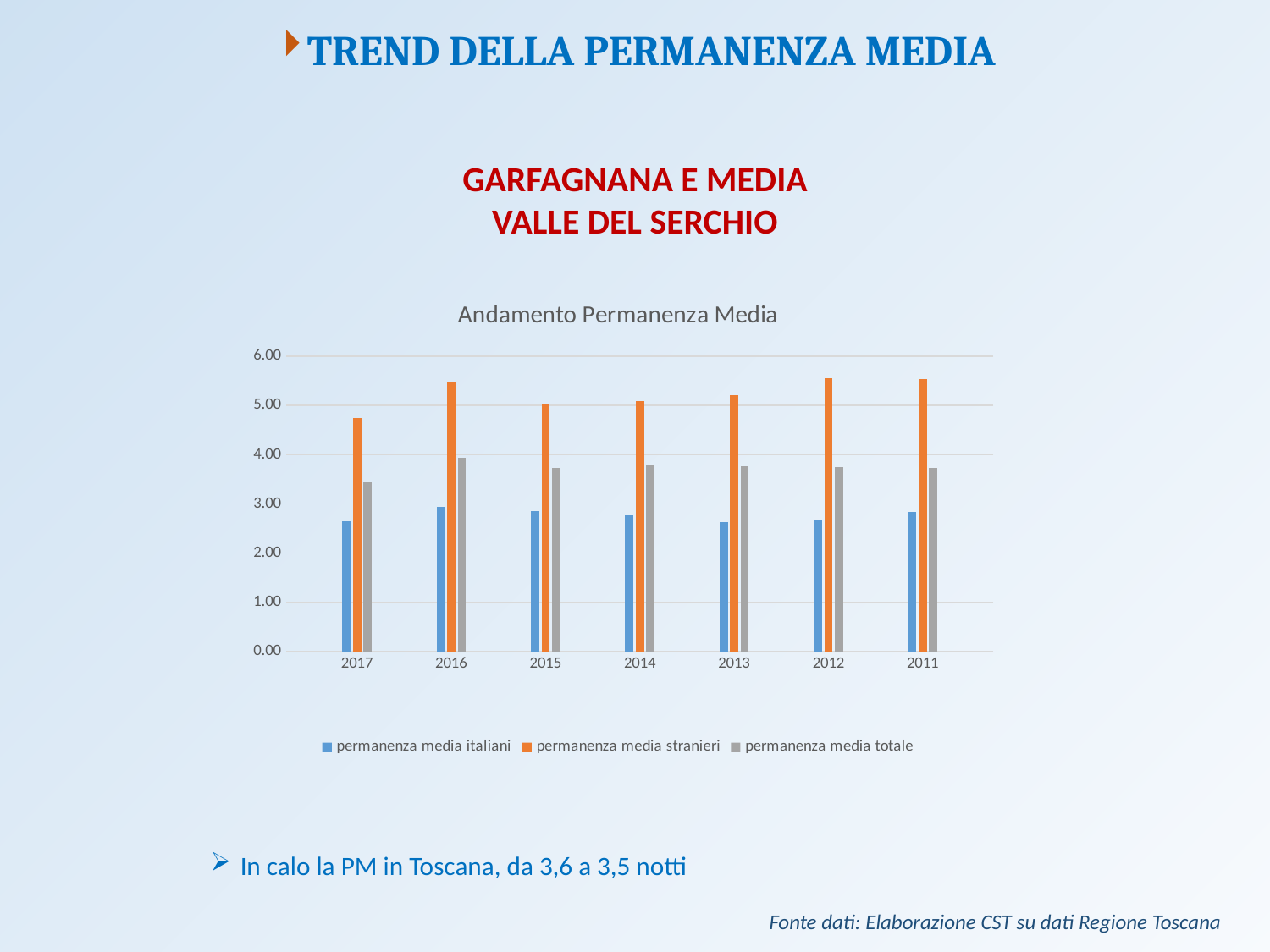
What is the title of the chart? Andamento Permanenza Media How many series does the legend list? 3 Which year has the highest value for permanenza media totale? 2016 Is the value for permanenza media stranieri in 2016 greater or less than 5.00? greater What kind of chart is shown on the slide? bar chart How many years are shown on the x axis? 7 Is the value for permanenza media italiani in 2017 greater or less than 3.00? less Which colour represents permanenza media stranieri in the chart? orange Is the value for permanenza media stranieri in 2017 greater or less than 5.00? less Which year has the lowest value for permanenza media totale? 2017 Which year has the lowest value for permanenza media stranieri? 2017 In 2014, which is larger: permanenza media italiani or permanenza media stranieri? permanenza media stranieri